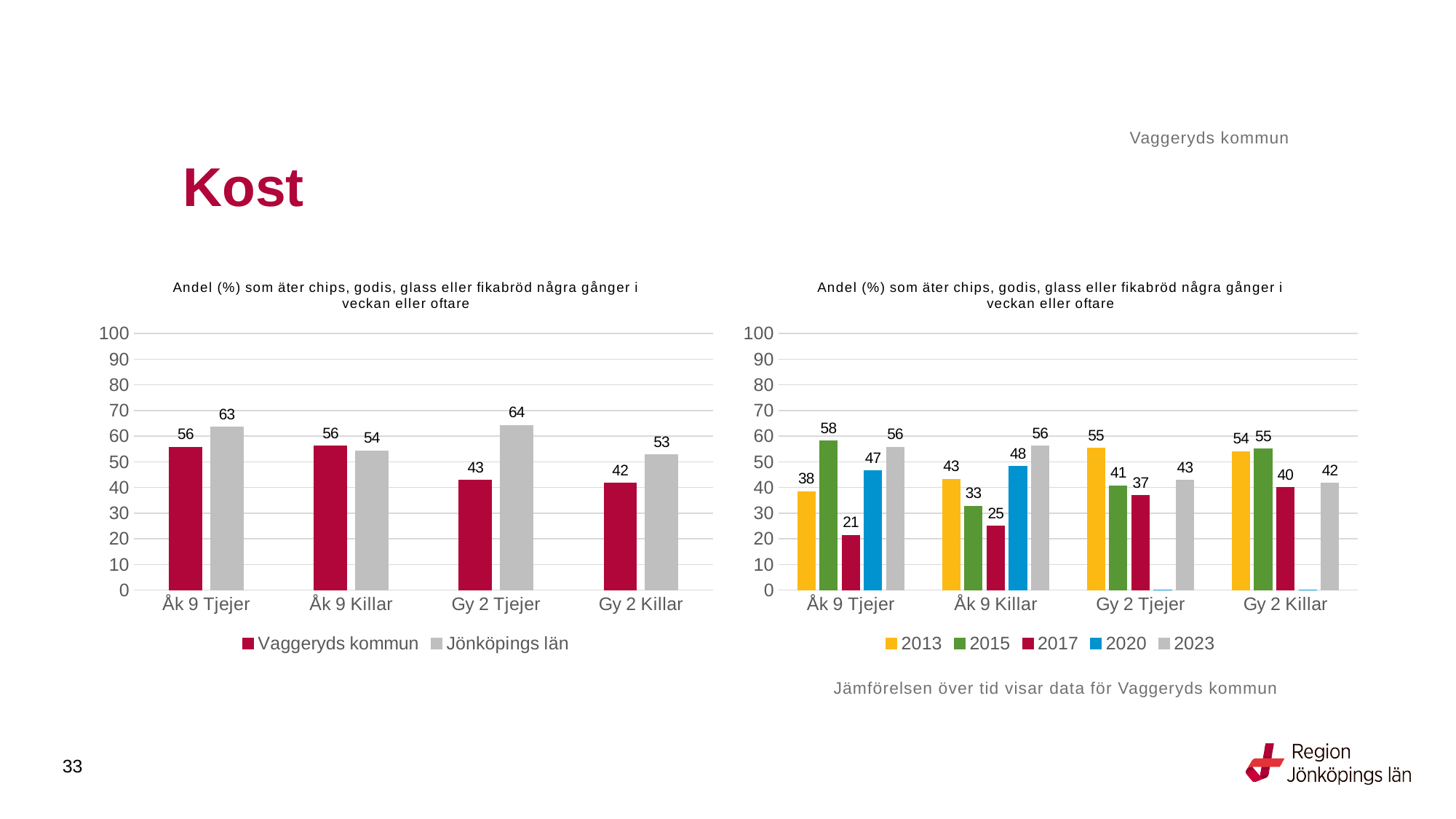
In the left chart, which category has the highest value for Jönköpings län? Gy 2 Tjejer How many series does the legend of the left chart list? 2 In the left chart, what is the value for Jönköpings län for Åk 9 Tjejer? 63 In the right chart, what is the difference between the 2015 and 2017 values for Åk 9 Tjejer? 37 In the right chart, what is the value for 2017 for Åk 9 Tjejer? 21 In the right chart, what is the value for 2020 for Åk 9 Killar? 48 In the left chart, which is larger for Åk 9 Killar: Vaggeryds kommun or Jönköpings län? Vaggeryds kommun How many series does the legend of the right chart list? 5 What type of chart is the right chart? Bar chart In the left chart, what is the value for Vaggeryds kommun for Gy 2 Tjejer? 43 In the right chart, which year has the lowest value for Gy 2 Killar? 2017 In the left chart, what is the difference between Jönköpings län and Vaggeryds kommun for Gy 2 Tjejer? 21